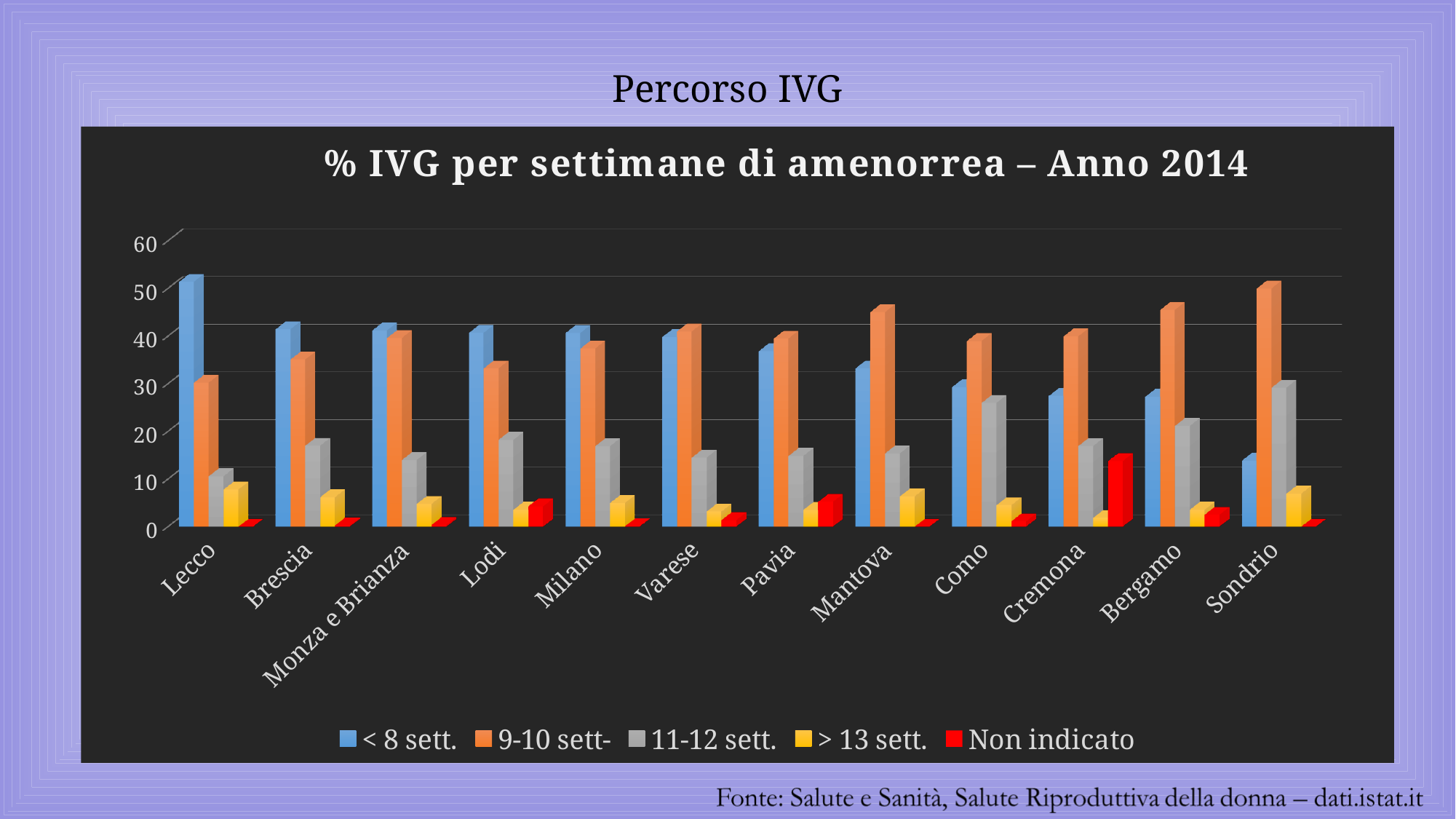
Which province has the highest value for the 'Non indicato' series? Cremona For Lecco, which is larger: the '< 8 sett.' value or the '9-10 sett-' value? < 8 sett. Is the '< 8 sett.' value for Sondrio greater or less than 20? less Which province has the lowest value for the '< 8 sett.' series? Sondrio How many provinces (categories) are shown on the x axis? 12 Which province has the highest value for the '< 8 sett.' series? Lecco Is the '9-10 sett-' value for Lecco greater or less than 40? less Is the '< 8 sett.' value for Lecco greater or less than 40? greater What kind of chart is shown on the slide? bar chart For Sondrio, which is larger: the '< 8 sett.' value or the '9-10 sett-' value? 9-10 sett- How many series does the legend list? 5 What is the title of the chart? % IVG per settimane di amenorrea – Anno 2014